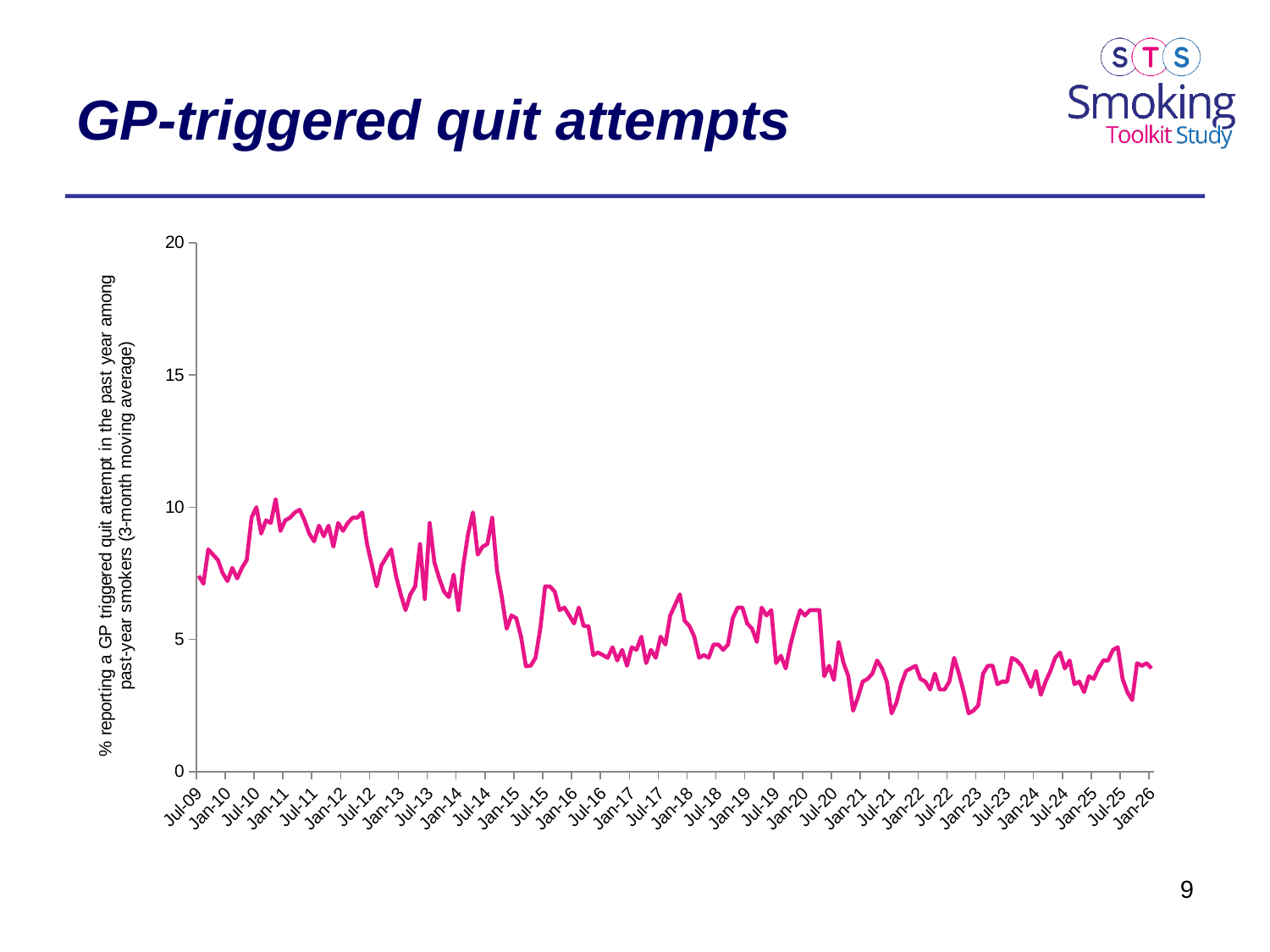
What is the first date label on the x axis? Jul-09 What is the title of the slide's chart? GP-triggered quit attempts Is the value for Jan-21 greater or less than 5? less Is the value for Jul-22 greater or less than 5? less Is the value for Jan-11 greater or less than 5? greater Overall, do the values rise or fall from Jul-09 to Jan-26? fall How many lines are plotted on the chart? 1 What kind of chart is shown on the slide? line chart